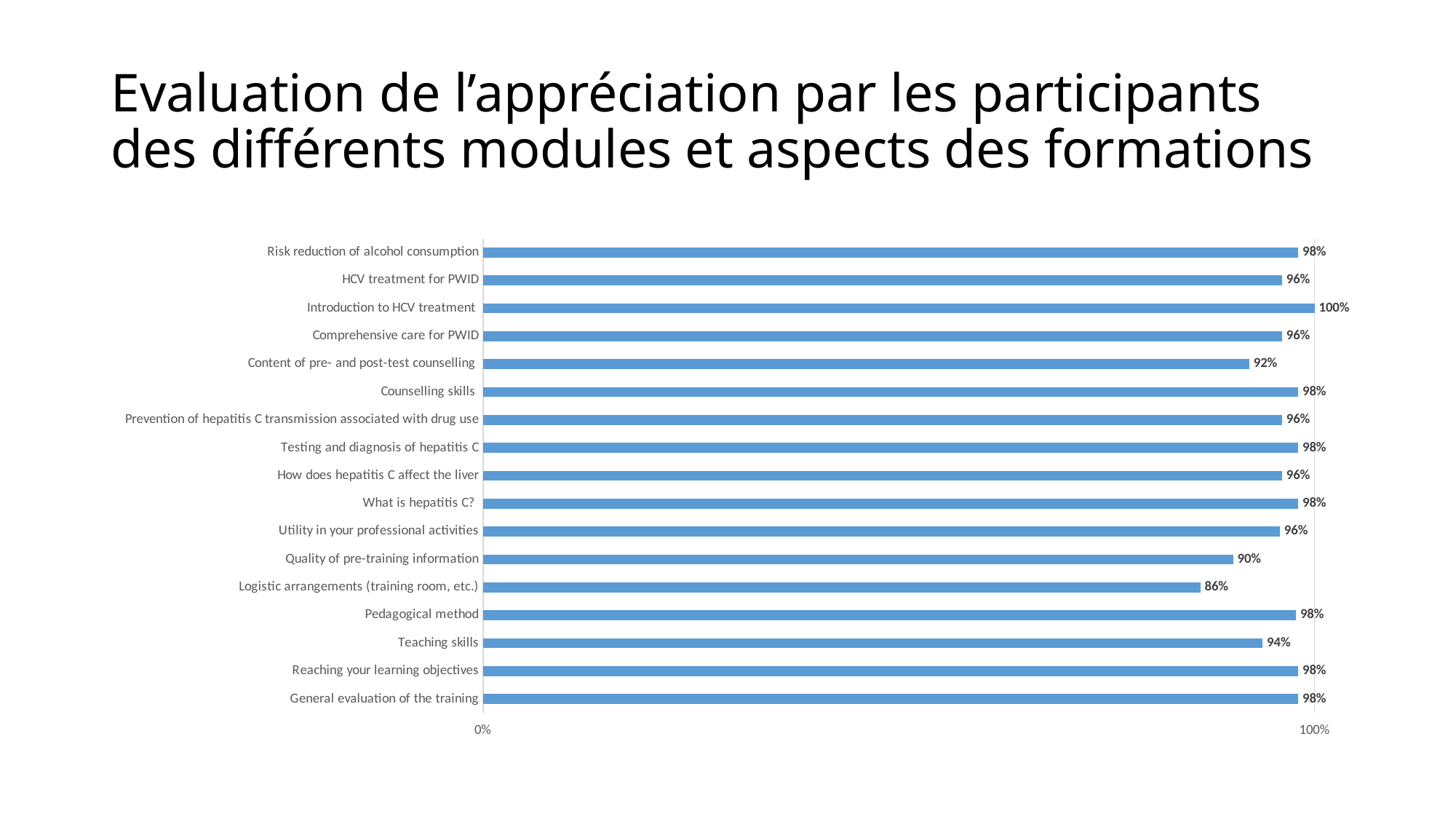
What is the value for Logistic arrangements (training room, etc.)? 86% What is the difference between the values for Introduction to HCV treatment and Logistic arrangements (training room, etc.)? 14% How many categories are shown in the chart? 17 Which category has the highest value? Introduction to HCV treatment What is the difference between the values for HCV treatment for PWID and Quality of pre-training information? 6% What is the value for Quality of pre-training information? 90% Which category has the lowest value? Logistic arrangements (training room, etc.) What kind of chart is shown on the slide? Bar chart What is the value for Content of pre- and post-test counselling? 92% What is the value for Introduction to HCV treatment? 100% Which is larger, the value for Teaching skills or the value for Pedagogical method? Pedagogical method What is the value for Teaching skills? 94%